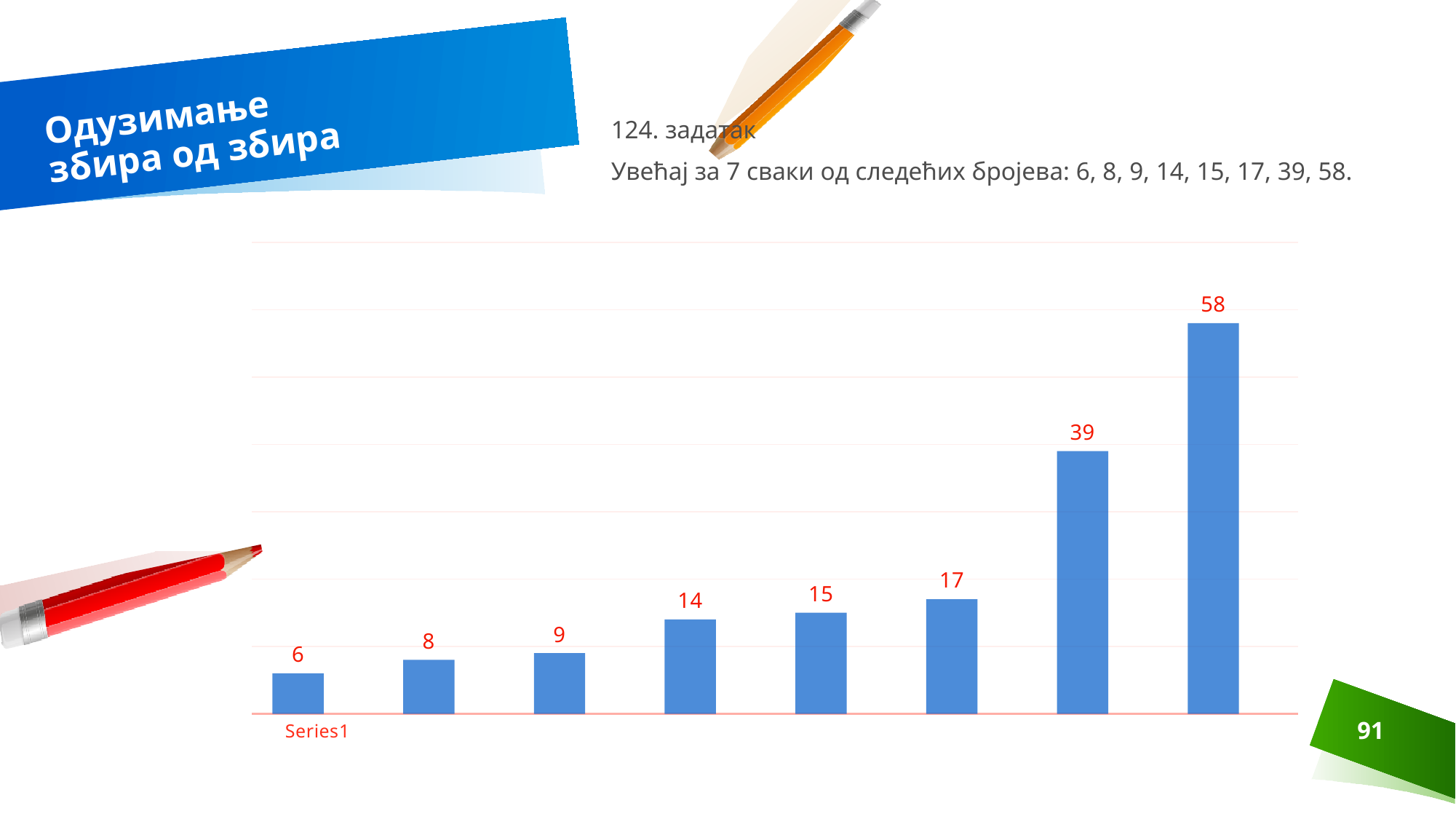
What category label is printed below the first bar of the chart? Series1 What is the value shown on the shortest bar in the chart? 6 Which is larger, the value of the sixth bar (17) or the value of the fifth bar (15)? 17 Do the bar values rise or fall from left to right across the chart? rise What is the data label on the first (leftmost) bar of the chart? 6 What is the data label on the fourth bar from the left in the chart? 14 What is the difference between the values of the last bar (58) and the second-to-last bar (39)? 19 What is the value shown on the tallest bar in the chart? 58 How many bars are plotted in the chart? 8 What is the difference between the values of the second bar (8) and the first bar (6)? 2 What is the data label on the seventh bar from the left in the chart? 39 What kind of chart is shown on the slide? bar chart